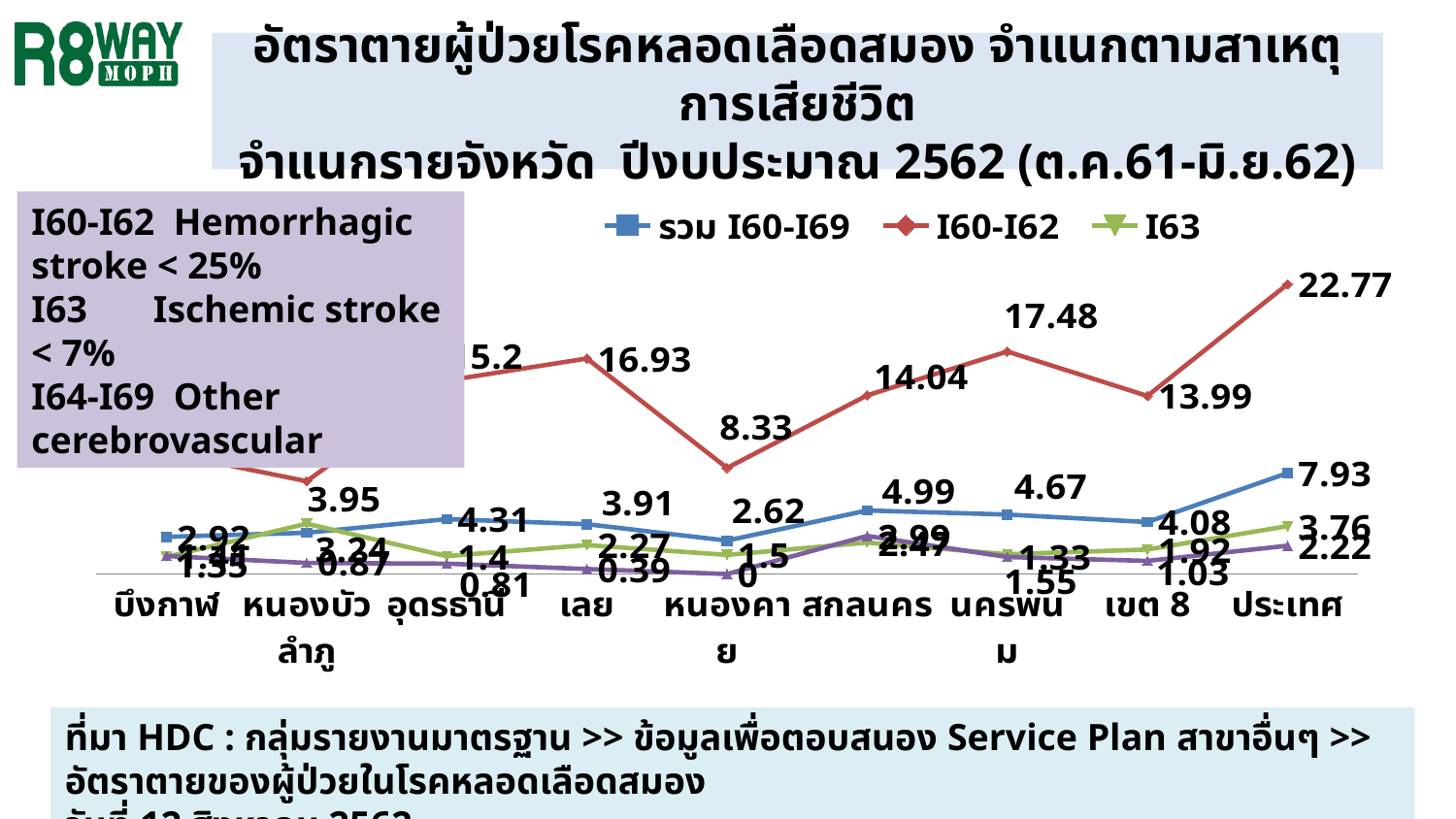
What type of chart is shown on the slide? line chart How many categories are shown along the x axis of the chart? 9 What is the value of the รวม I60-I69 series for ประเทศ? 7.93 What is the value of the I60-I62 series for หนองคาย? 8.33 Which category has the highest value in the I60-I62 series? ประเทศ What is the value of the I60-I62 series for ประเทศ? 22.77 Which category has the highest value in the รวม I60-I69 series? ประเทศ What is the value of the I60-I62 series for นครพนม? 17.48 In the I60-I62 series, which is larger: เลย or หนองคาย? เลย What is the value of the รวม I60-I69 series for สกลนคร? 4.99 What is the difference between the I60-I62 values for ประเทศ and เขต 8? 8.78 What is the first entry listed in the chart legend? รวม I60-I69